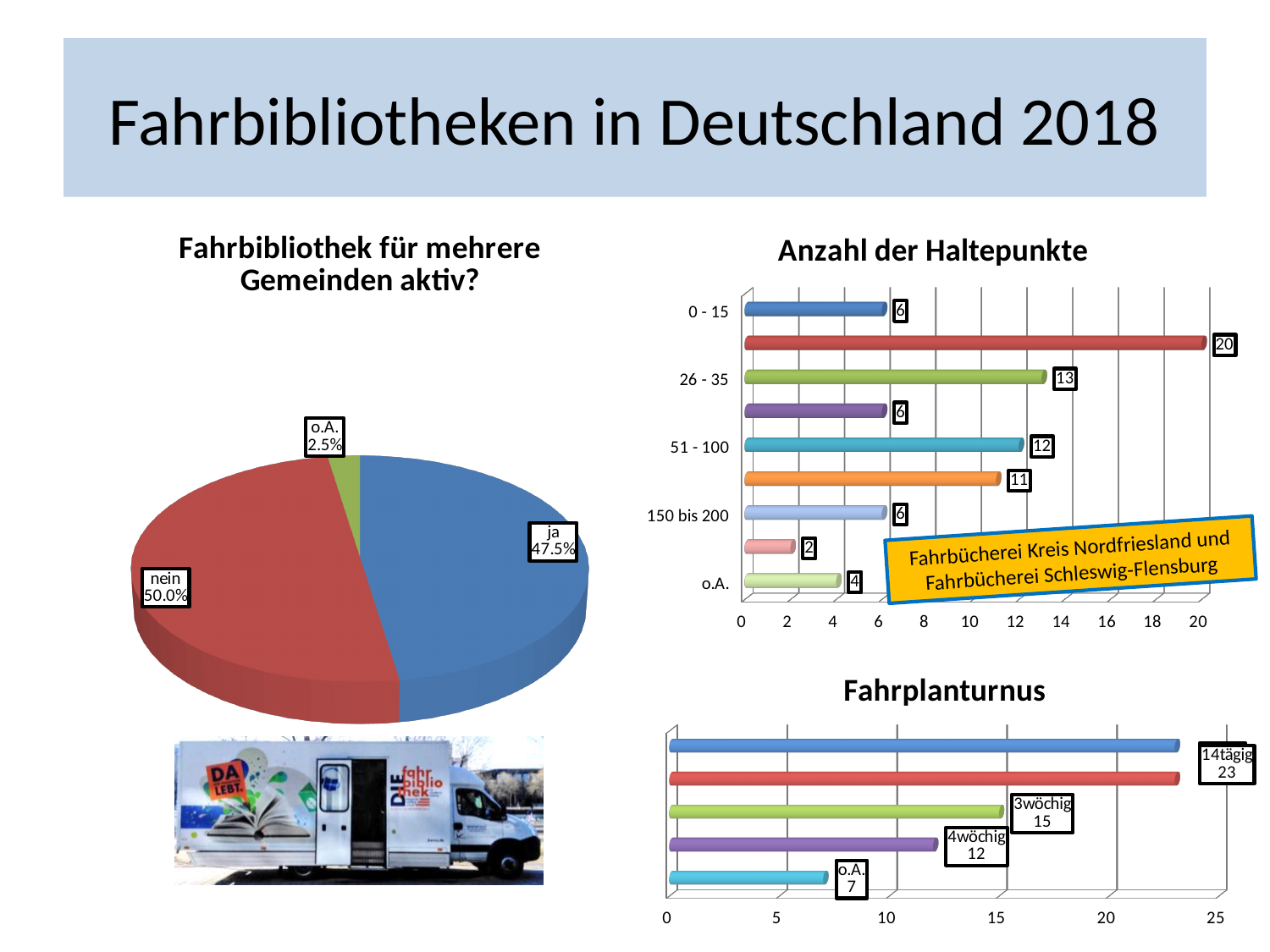
What kind of chart is 'Fahrplanturnus'? bar chart In the pie chart 'Fahrbibliothek für mehrere Gemeinden aktiv?', what share does the 'nein' slice have? 50.0% In the pie chart 'Fahrbibliothek für mehrere Gemeinden aktiv?', what share does the 'ja' slice have? 47.5% In the chart 'Anzahl der Haltepunkte', what is the value for '51 - 100'? 12 In the chart 'Fahrplanturnus', what is the value for '3wöchig'? 15 In the chart 'Anzahl der Haltepunkte', what is the value for 'o.A.'? 4 How many bars are plotted in the chart 'Anzahl der Haltepunkte'? 9 In the chart 'Fahrplanturnus', what is the difference between the values for '3wöchig' and '4wöchig'? 3 In the pie chart 'Fahrbibliothek für mehrere Gemeinden aktiv?', which slice is the smallest? o.A. In the chart 'Anzahl der Haltepunkte', what is the value for '26 - 35'? 13 How many slices does the pie chart 'Fahrbibliothek für mehrere Gemeinden aktiv?' have? 3 In the chart 'Anzahl der Haltepunkte', what is the highest value shown on any bar? 20